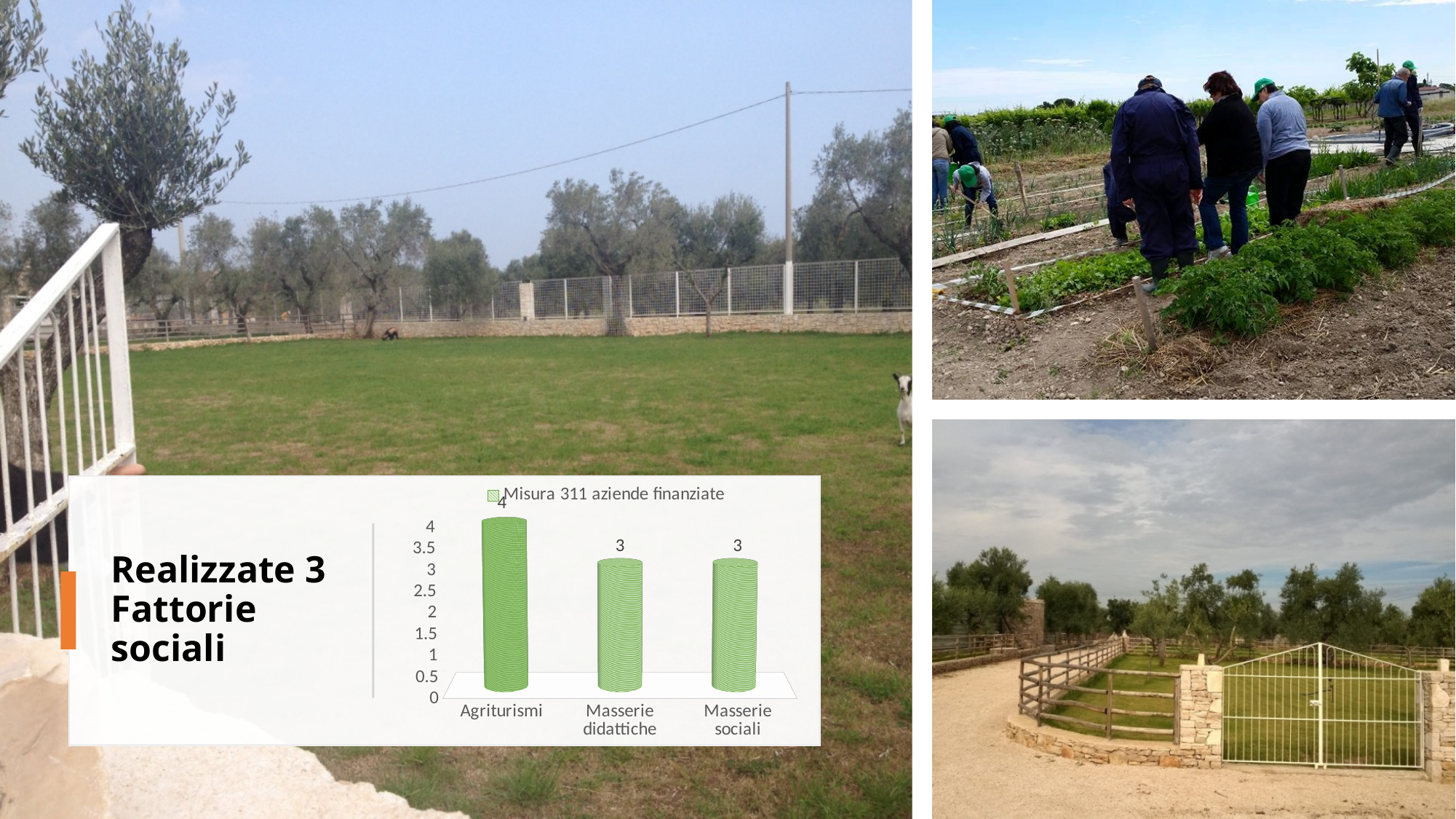
What is the value for Masserie sociali? 3 What is the value for Masserie didattiche? 3 What is the series name shown in the legend? Misura 311 aziende finanziate Is the value for Agriturismi greater or less than 3.5? greater How many categories are shown on the x axis? 3 What is the difference between the values for Agriturismi and Masserie sociali? 1 What kind of chart is shown on the slide? bar chart Which is larger, the value for Agriturismi or the value for Masserie didattiche? Agriturismi Which category has the highest value? Agriturismi How many series does the legend list? 1 What colour are the bars in the chart? green What is the value for Agriturismi? 4